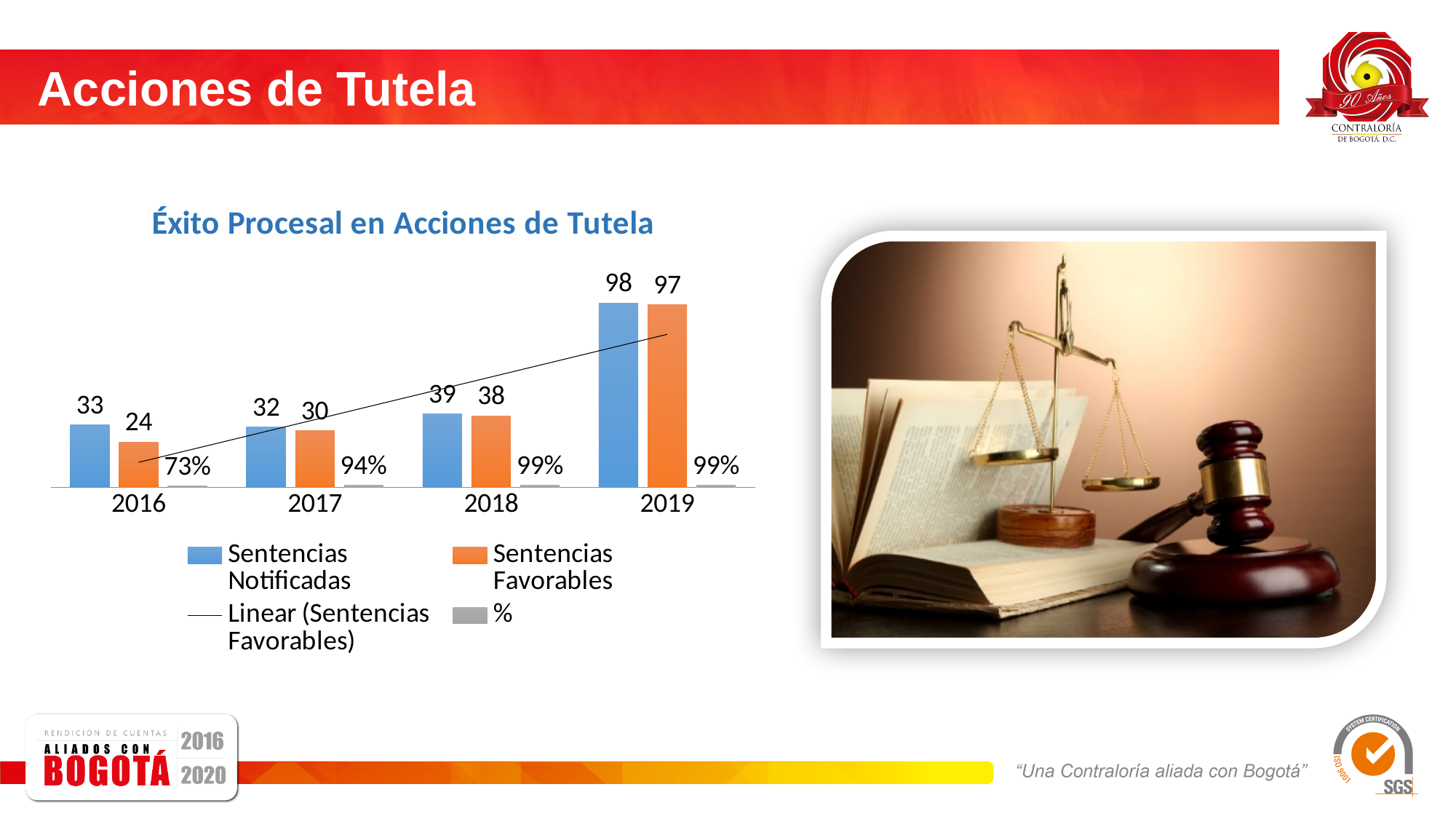
What percentage (%) is shown for 2017? 94% Which year has the lowest value of Sentencias Favorables? 2016 What is the value of Sentencias Notificadas for 2019? 98 Which is larger: Sentencias Favorables in 2017 or Sentencias Favorables in 2018? Sentencias Favorables in 2018 Do the Sentencias Favorables values rise or fall from 2016 to 2019? Rise How many entries does the legend list? 4 What is the value of Sentencias Favorables for 2016? 24 What kind of chart is used to show Sentencias Notificadas and Sentencias Favorables? Bar chart What is the difference between Sentencias Notificadas and Sentencias Favorables in 2016? 9 How many years are shown on the x axis? 4 Which year has the highest value of Sentencias Notificadas? 2019 What is the title of the chart? Éxito Procesal en Acciones de Tutela